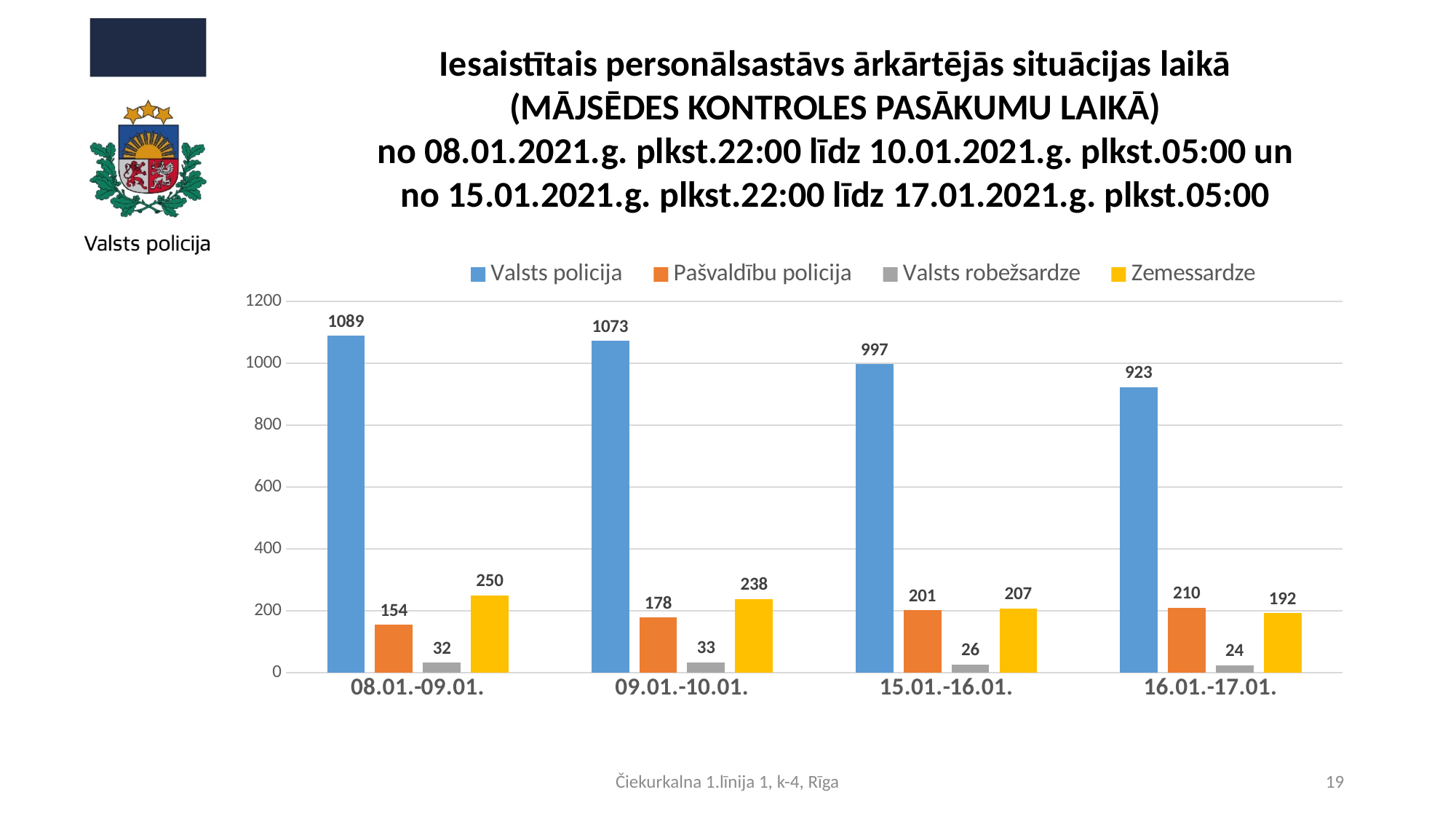
What is the value for Valsts robežsardze in the 16.01.-17.01. period? 24 What is the value for Zemessardze in the 09.01.-10.01. period? 238 What kind of chart is shown on the slide? bar chart Is the value for Valsts policija in the 15.01.-16.01. period greater or less than 800? greater How many periods are shown on the x axis? 4 How many series does the legend list? 4 In which period is the Pašvaldību policija value highest? 16.01.-17.01. In which period is the Valsts policija value lowest? 16.01.-17.01. What is the value for Valsts policija in the 08.01.-09.01. period? 1089 What is the difference between the Valsts policija values for 08.01.-09.01. and 16.01.-17.01.? 166 Which is larger in the 15.01.-16.01. period: Pašvaldību policija or Zemessardze? Zemessardze Do the Zemessardze values rise or fall across the periods from left to right? fall